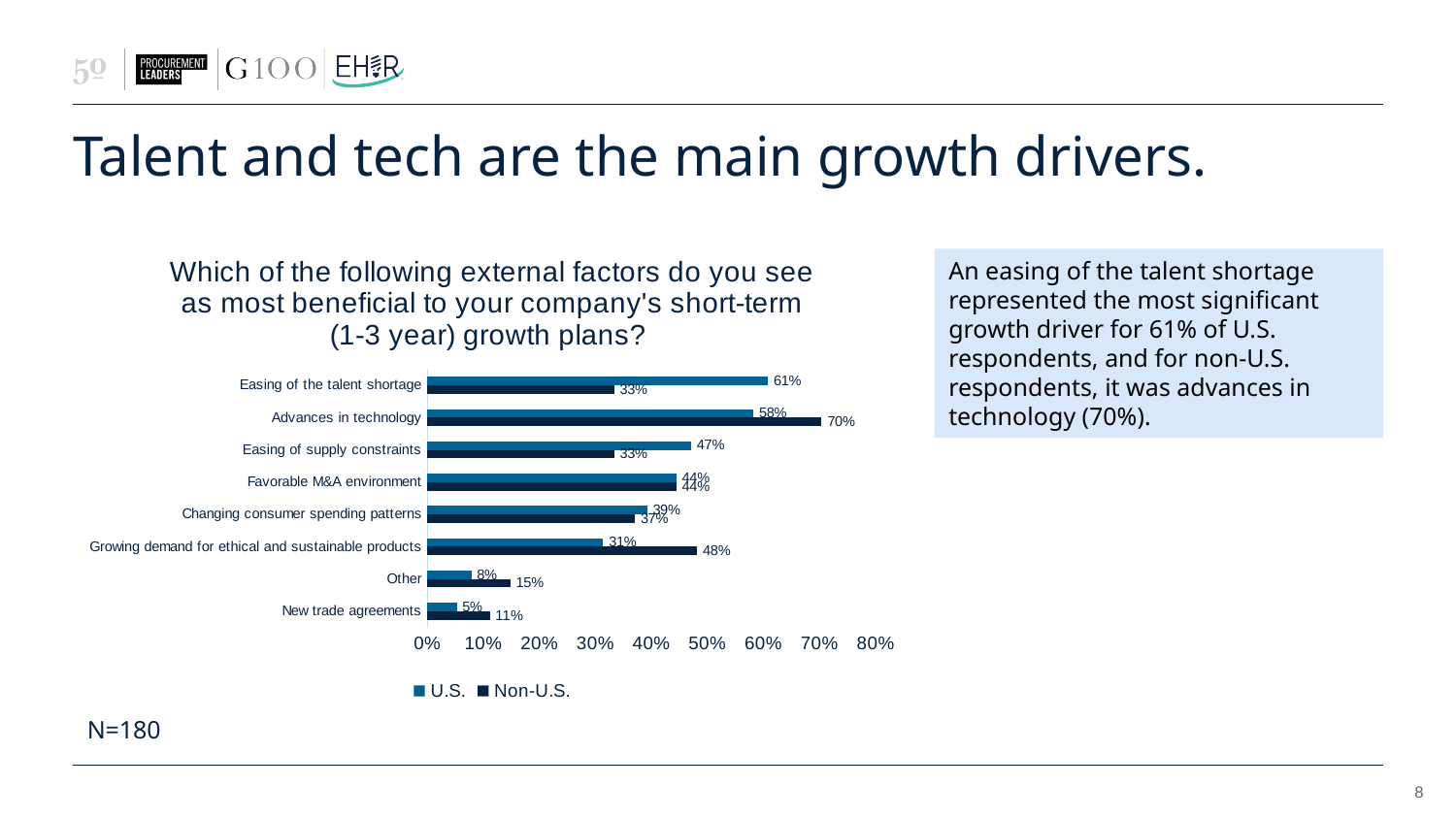
How many series does the legend list? 2 What is the sample size (N) shown on the slide? N=180 What is the Non-U.S. value for 'Growing demand for ethical and sustainable products'? 48% What percentage of U.S. respondents selected 'Easing of the talent shortage'? 61% What type of chart is shown on the slide? Bar chart What percentage of Non-U.S. respondents selected 'Advances in technology'? 70% Which external factor has the lowest Non-U.S. value? New trade agreements What is the difference between the U.S. and Non-U.S. values for 'Easing of the talent shortage'? 28% How many external factors are listed on the chart? 8 Which external factor has the highest U.S. value? Easing of the talent shortage What is the difference between the Non-U.S. and U.S. values for 'Advances in technology'? 12% For 'Easing of supply constraints', which is larger: the U.S. value or the Non-U.S. value? U.S.